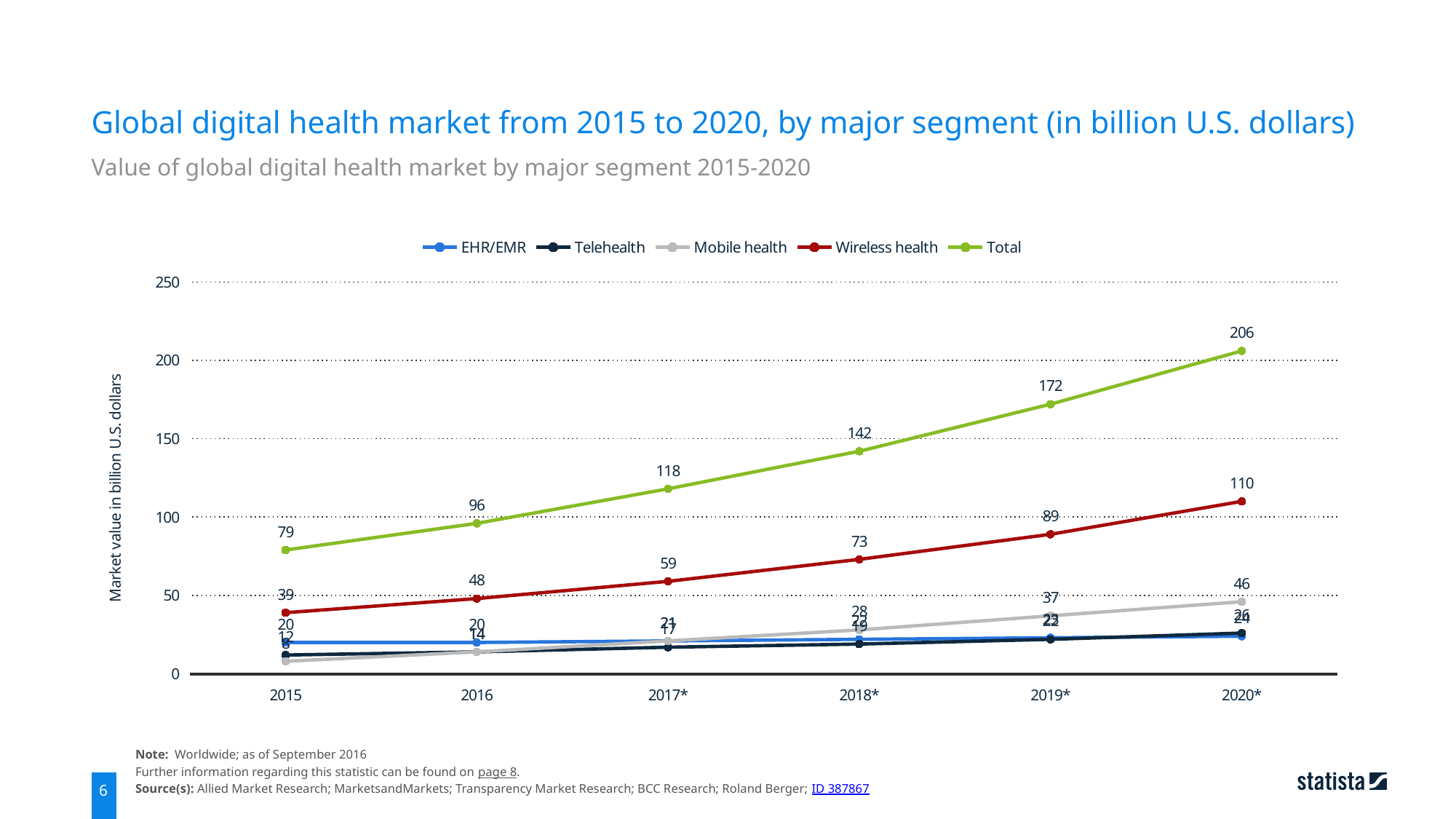
Is the Wireless health value for 2020* greater or less than 100? greater What is the difference between the Total values for 2020* and 2019*? 34 In which year is the Total value highest? 2020* What kind of chart is shown on the slide? line chart Does the Total series rise or fall from 2015 to 2020*? rise What is the Total value for 2020*? 206 How many series does the legend list? 5 What is the Mobile health value for 2020*? 46 What is the Wireless health value for 2018*? 73 How many years are shown on the x axis? 6 What is the Total value for 2015? 79 Which is larger in 2017*: the Total value or the Wireless health value? Total